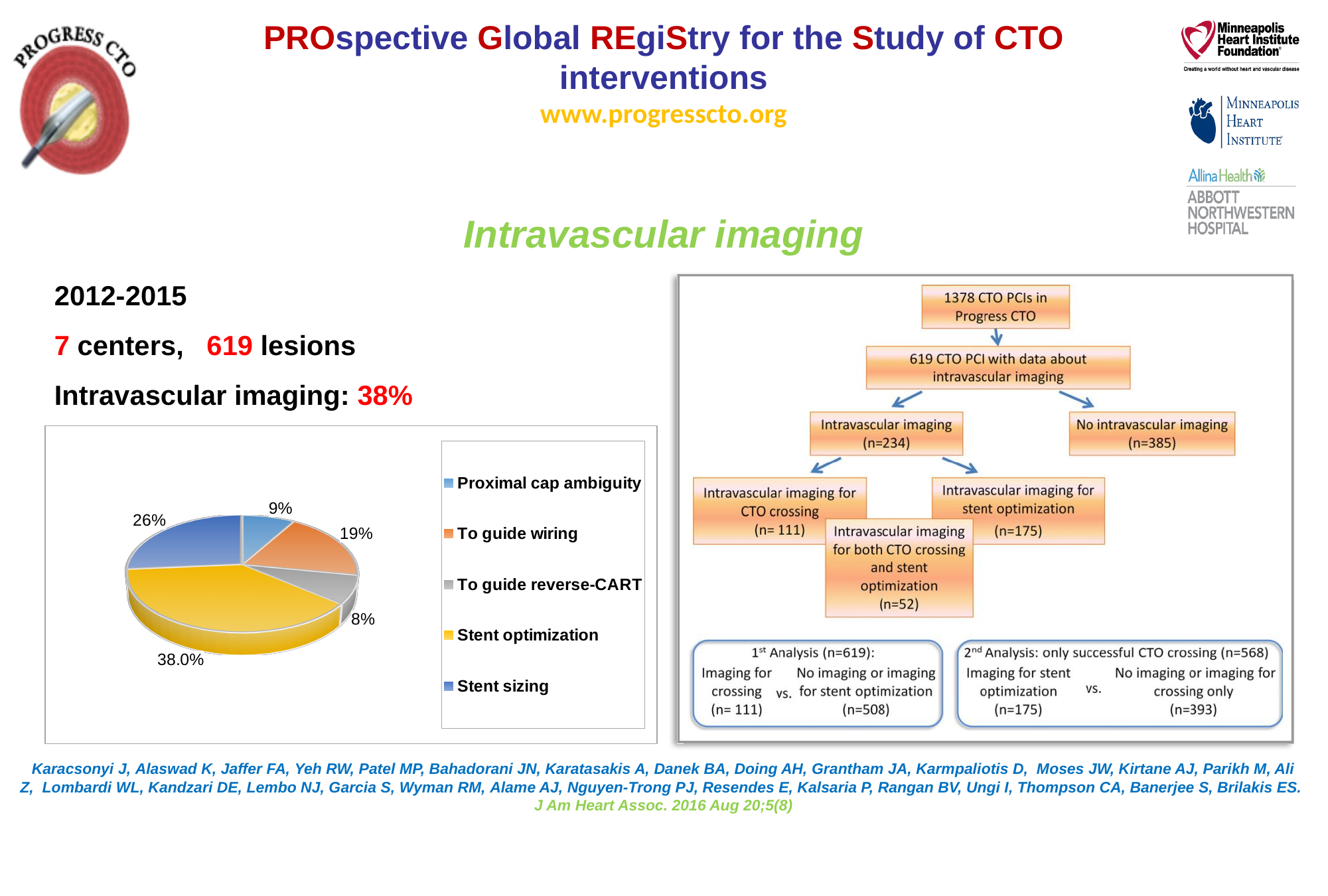
How many categories does the pie chart legend list? 5 In the pie chart, what percentage is shown for To guide wiring? 19% What type of chart is shown on the left side of the slide? Pie chart In the pie chart, what percentage is shown for To guide reverse-CART? 8% In the pie chart, what percentage is shown for Proximal cap ambiguity? 9% In the pie chart, what percentage is shown for Stent optimization? 38.0% In the pie chart, what is the difference in percentage points between Stent optimization and Stent sizing? 12 In the pie chart, which is larger: To guide wiring or Proximal cap ambiguity? To guide wiring In the pie chart, what percentage is shown for Stent sizing? 26% What colour is the Stent optimization slice in the pie chart? Yellow Which category has the largest slice in the pie chart? Stent optimization Which category has the smallest slice in the pie chart? To guide reverse-CART